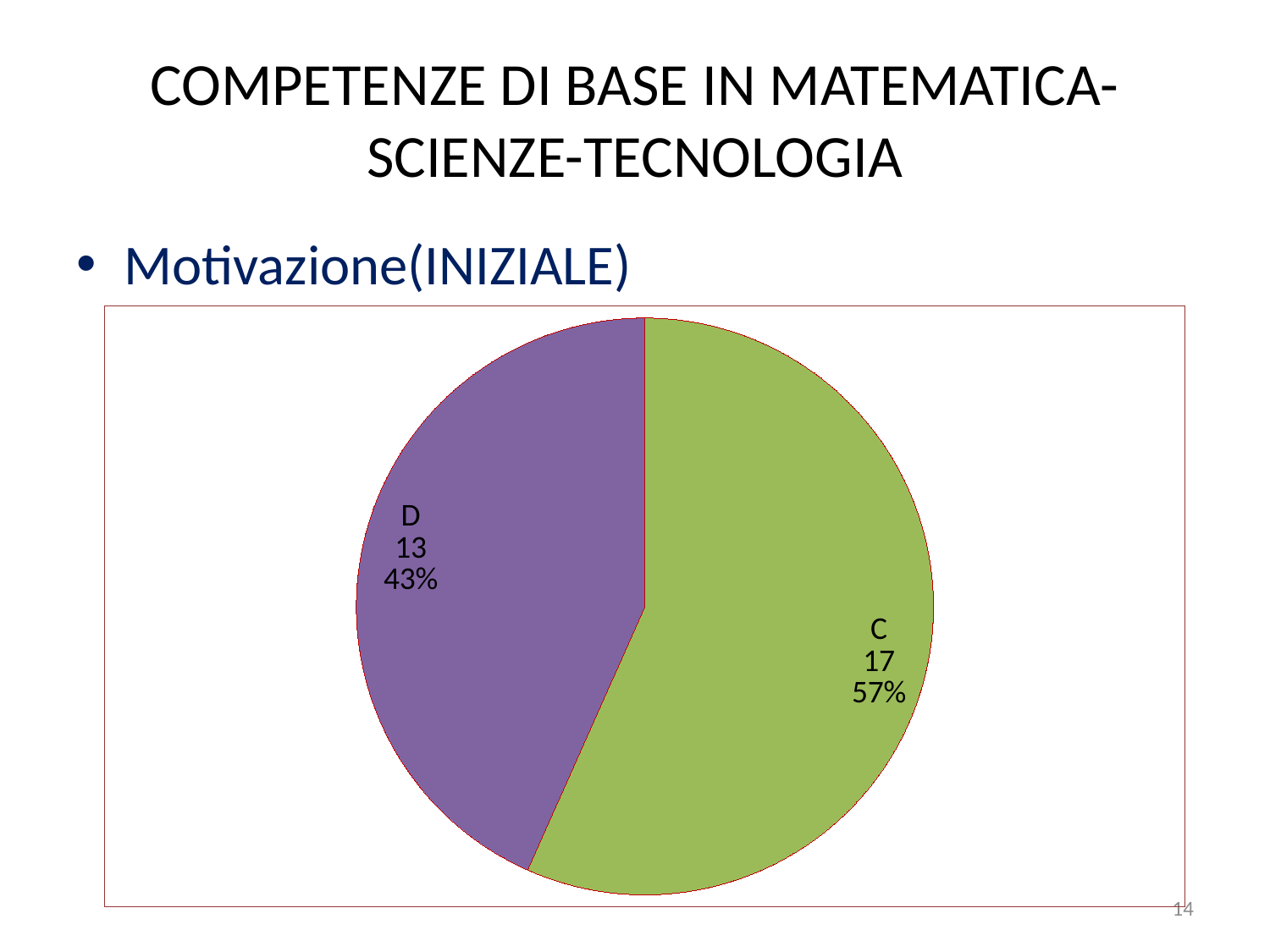
What share of the pie does slice D represent? 43% What is the total of the values of all slices in the pie chart? 30 What is the value for slice C? 17 What is the value for slice D? 13 What share of the pie does slice C represent? 57% How many slices does the pie chart have? 2 What is the difference between the values of slice C and slice D? 4 Which slice is the smallest? D Which is larger, slice C or slice D? C Which slice is the largest? C What kind of chart is shown on the slide? pie chart What colour is slice D in the pie chart? purple